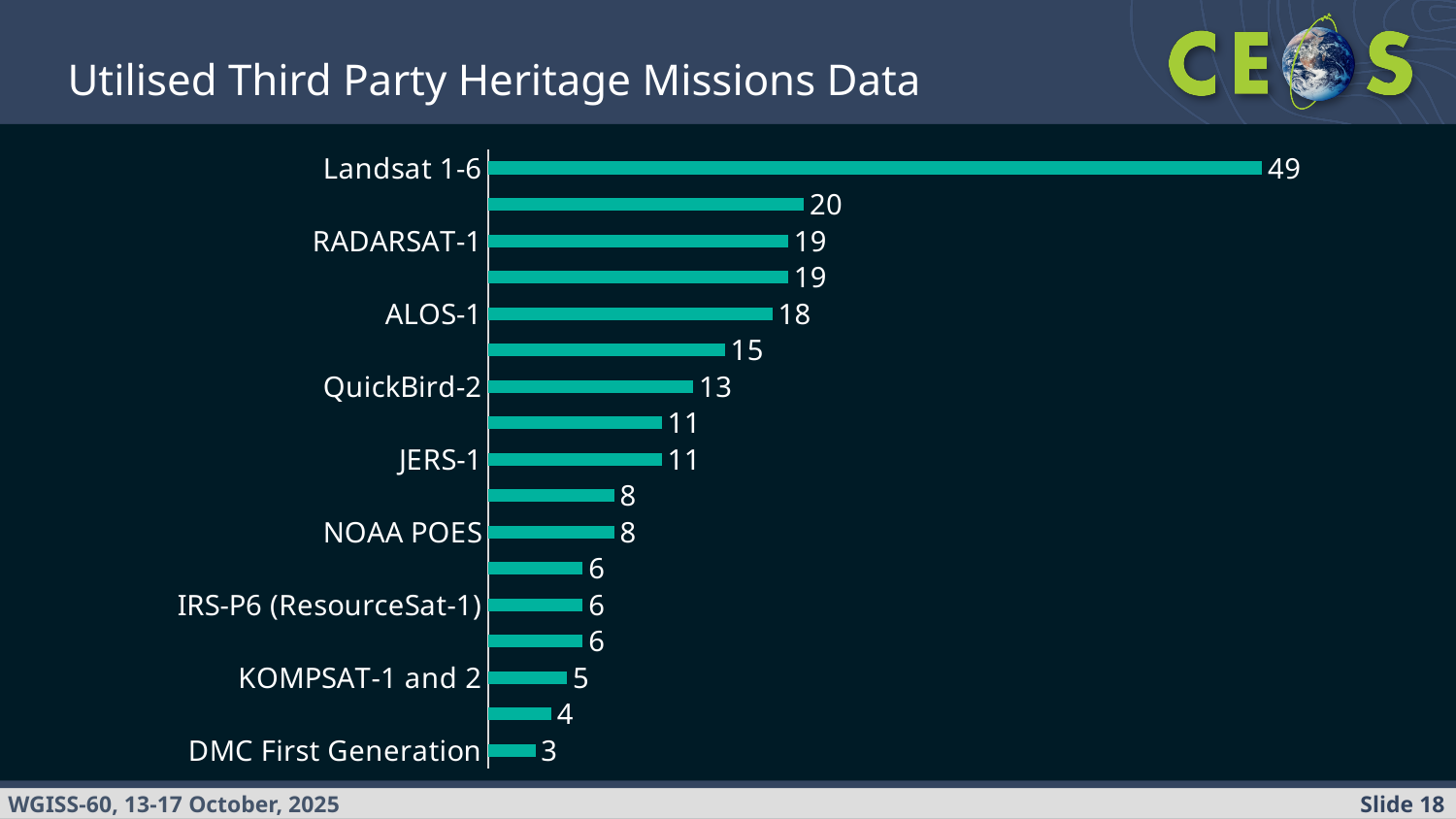
What is the title of the slide? Utilised Third Party Heritage Missions Data Which mission has the lowest value? DMC First Generation What is the value for QuickBird-2? 13 What is the difference between the values for Landsat 1-6 and RADARSAT-1? 30 How many bars are plotted in the chart? 17 What is the value for RADARSAT-1? 19 What is the value for Landsat 1-6? 49 What is the value for KOMPSAT-1 and 2? 5 What kind of chart is shown on the slide? Bar chart Which has a larger value, ALOS-1 or QuickBird-2? ALOS-1 Which mission has the highest value? Landsat 1-6 What is the value for DMC First Generation? 3